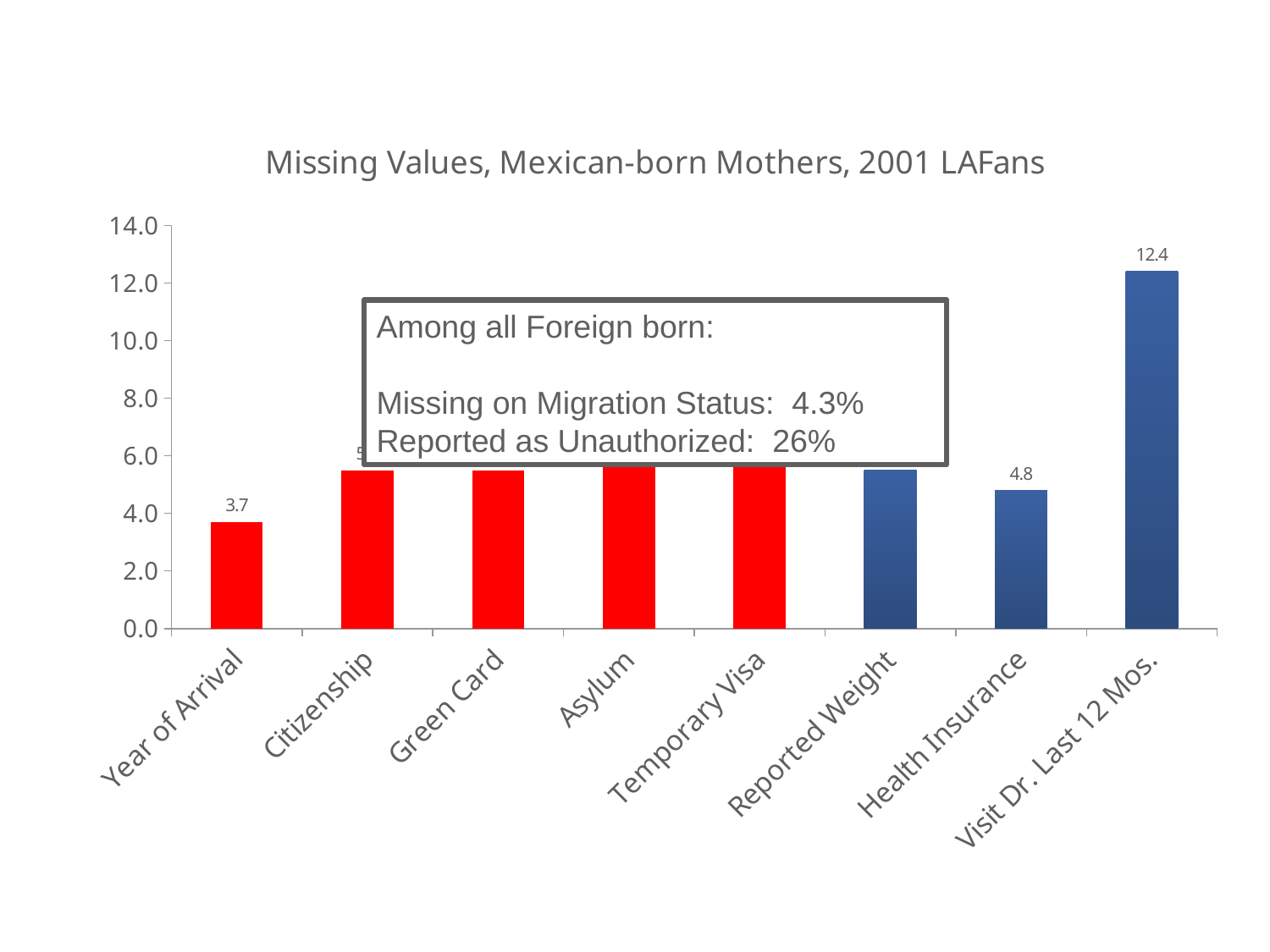
What is the difference between the values for Visit Dr. Last 12 Mos. and Year of Arrival? 8.7 What is the value for Year of Arrival? 3.7 Which category has the lowest value? Year of Arrival What is the title of the chart? Missing Values, Mexican-born Mothers, 2001 LAFans What is the value for Health Insurance? 4.8 Which is larger, the value for Health Insurance or the value for Year of Arrival? Health Insurance What is the difference between the values for Visit Dr. Last 12 Mos. and Health Insurance? 7.6 What is the value for Visit Dr. Last 12 Mos.? 12.4 Which category has the highest value? Visit Dr. Last 12 Mos. How many categories are shown on the x axis? 8 Is the value for Citizenship greater or less than 4.0? greater What kind of chart is shown on the slide? bar chart